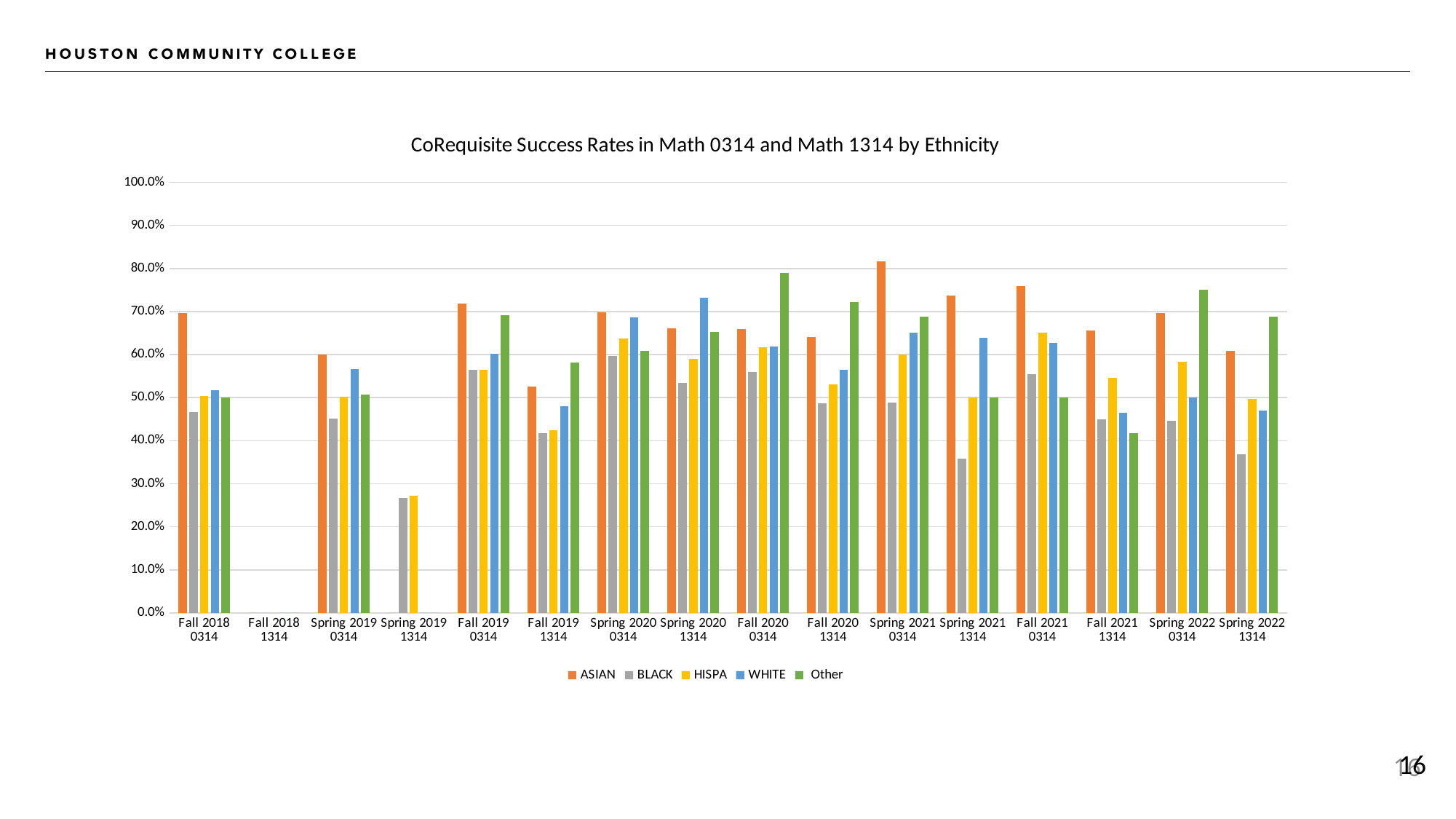
How many categories are shown along the x axis? 16 In Spring 2021 1314, which series has the lowest value? BLACK Which category on the x axis has no bars plotted? Fall 2018 1314 In Fall 2020 0314, which series has the highest value? Other What is the title of the chart? CoRequisite Success Rates in Math 0314 and Math 1314 by Ethnicity Is the ASIAN value for Spring 2021 0314 greater or less than 70.0%? greater Is the Other value for Fall 2020 0314 greater or less than 70.0%? greater Is the BLACK value for Spring 2019 1314 greater or less than 30.0%? less In Fall 2018 0314, which is larger, the ASIAN value or the BLACK value? ASIAN What kind of chart is shown on the slide? Bar chart How many series does the legend list? 5